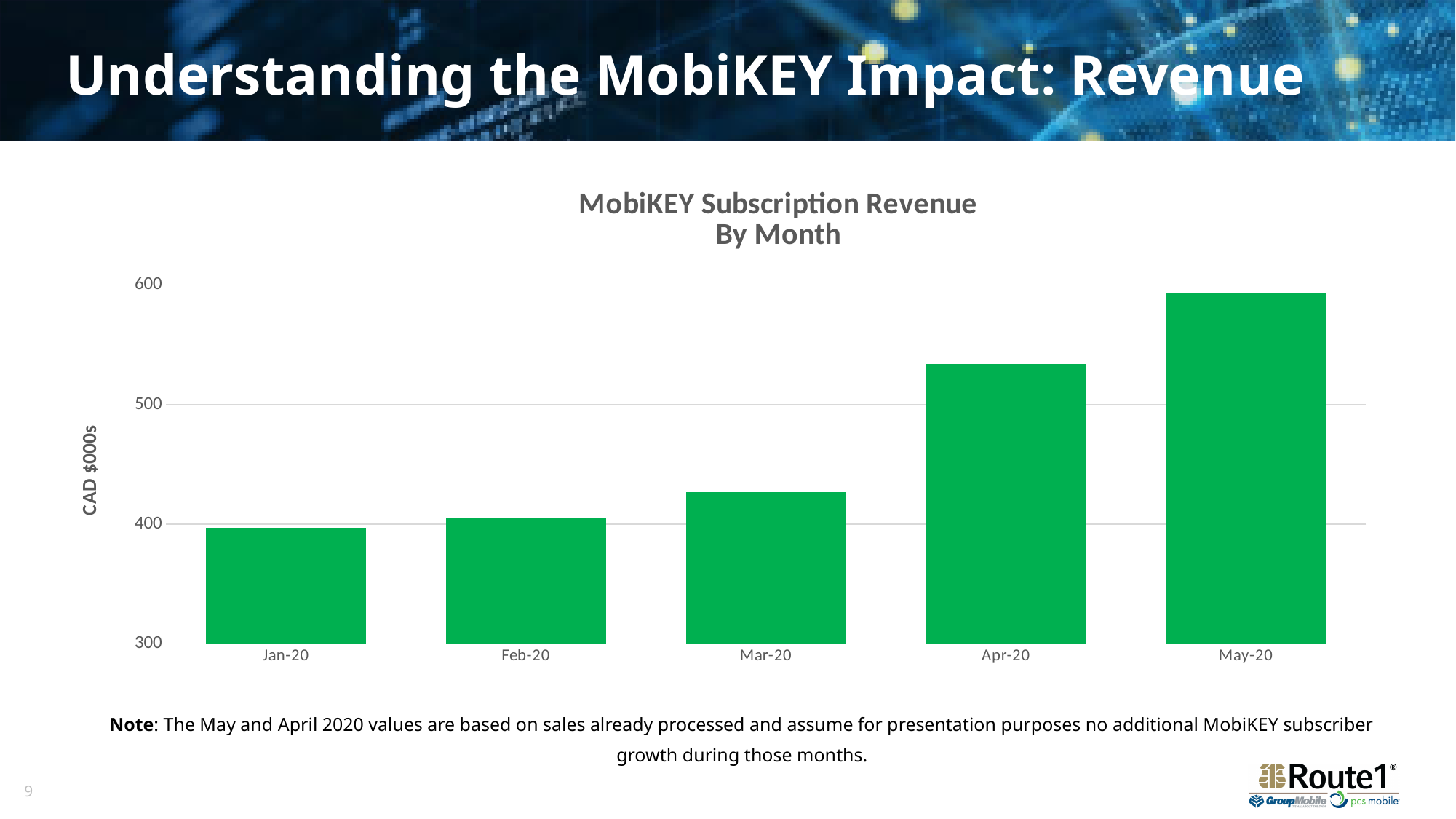
Is the value for Mar-20 greater or less than 500? less What is the label on the vertical axis of the chart? CAD $000s What is the title of the chart? MobiKEY Subscription Revenue By Month Which is larger, the revenue for Apr-20 or for Mar-20? Apr-20 Which month has the highest MobiKEY subscription revenue? May-20 What kind of chart is shown on the slide? bar chart Is the value for Apr-20 greater or less than 500? greater Do the revenue values rise or fall from Jan-20 to May-20? rise Is the value for May-20 greater or less than 600? less How many months are plotted in the MobiKEY Subscription Revenue By Month chart? 5 Which month has the lowest MobiKEY subscription revenue? Jan-20